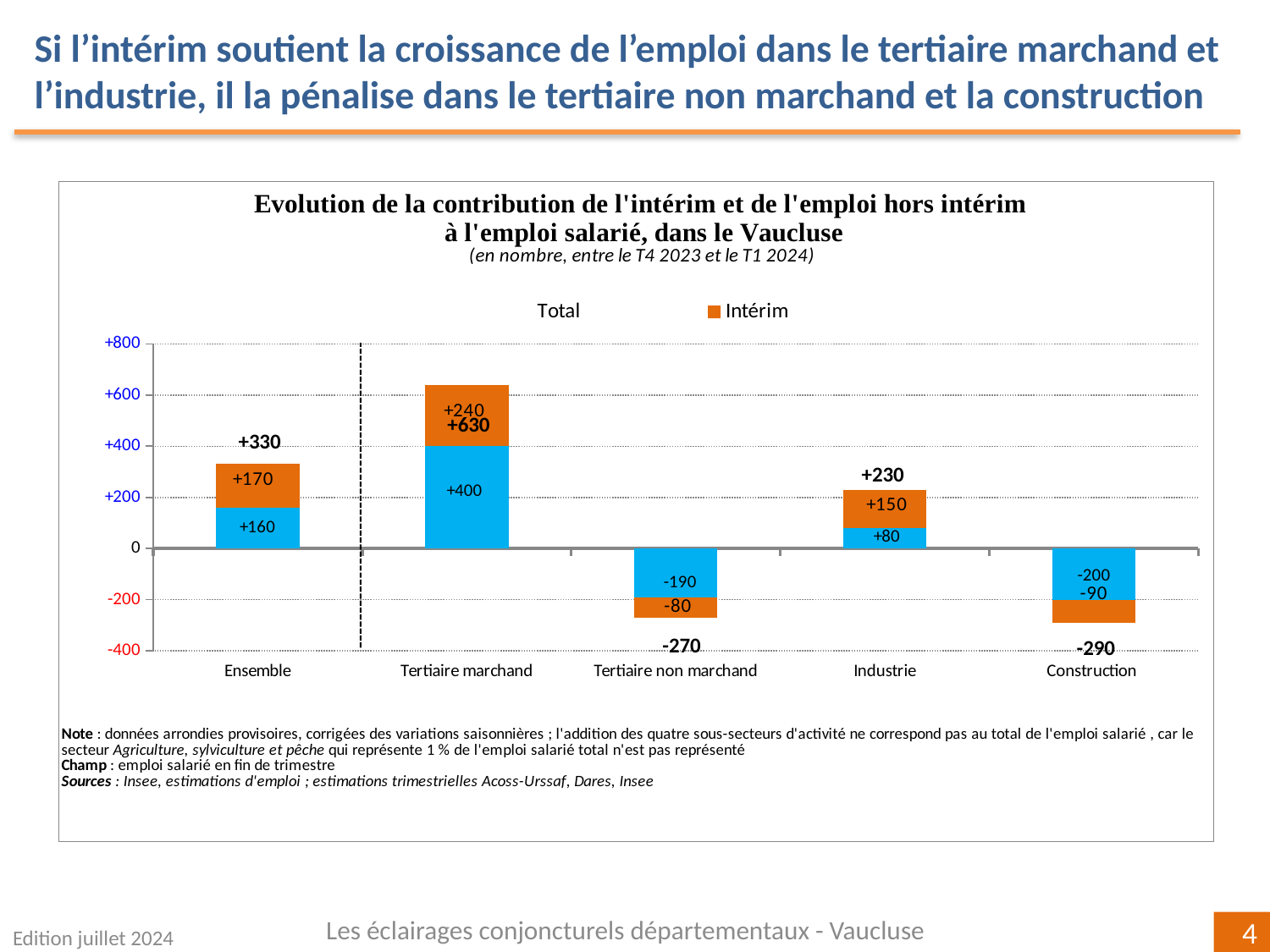
What is the total of the stacked bar for Industrie? +230 How many categories are shown on the x axis? 5 Which category has the highest total value? Tertiaire marchand What is the difference between the total for Tertiaire marchand and the total for Ensemble? 300 Which is larger in absolute terms, the Intérim value for Tertiaire non marchand or the Intérim value for Construction? Construction What kind of chart is this? Stacked bar chart What is the value of the blue segment for Ensemble? +160 What is the total value shown for Construction? -290 What colour represents the Intérim series in the legend? Orange Which category has the lowest total value? Construction What is the Intérim value for Industrie? +150 What is the Intérim value for Tertiaire marchand? +240